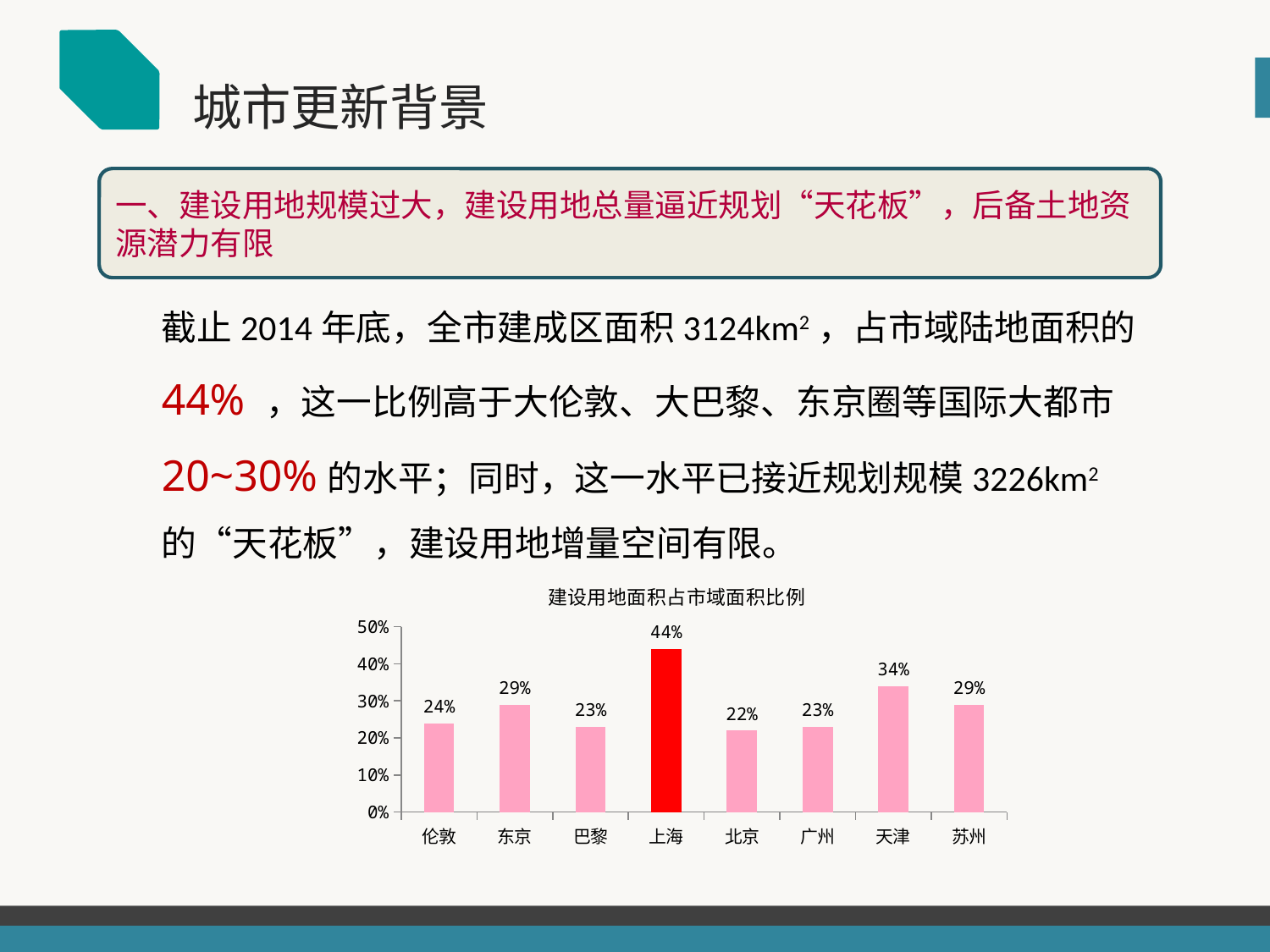
What is the difference between the values for 上海 and 天津? 10% Which city has the highest value in the chart? 上海 Which bar in the chart is coloured red rather than pink? 上海 What is the value for 天津 in the chart? 34% Which city has the lowest value in the chart? 北京 Is the value for 天津 greater or less than 30%? greater What is the value for 上海 in the chart? 44% What kind of chart is shown on the slide? bar chart Which is larger, the value for 东京 or the value for 巴黎? 东京 How many cities are shown in the chart? 8 What is the title of the chart? 建设用地面积占市域面积比例 What is the value for 伦敦 in the chart? 24%